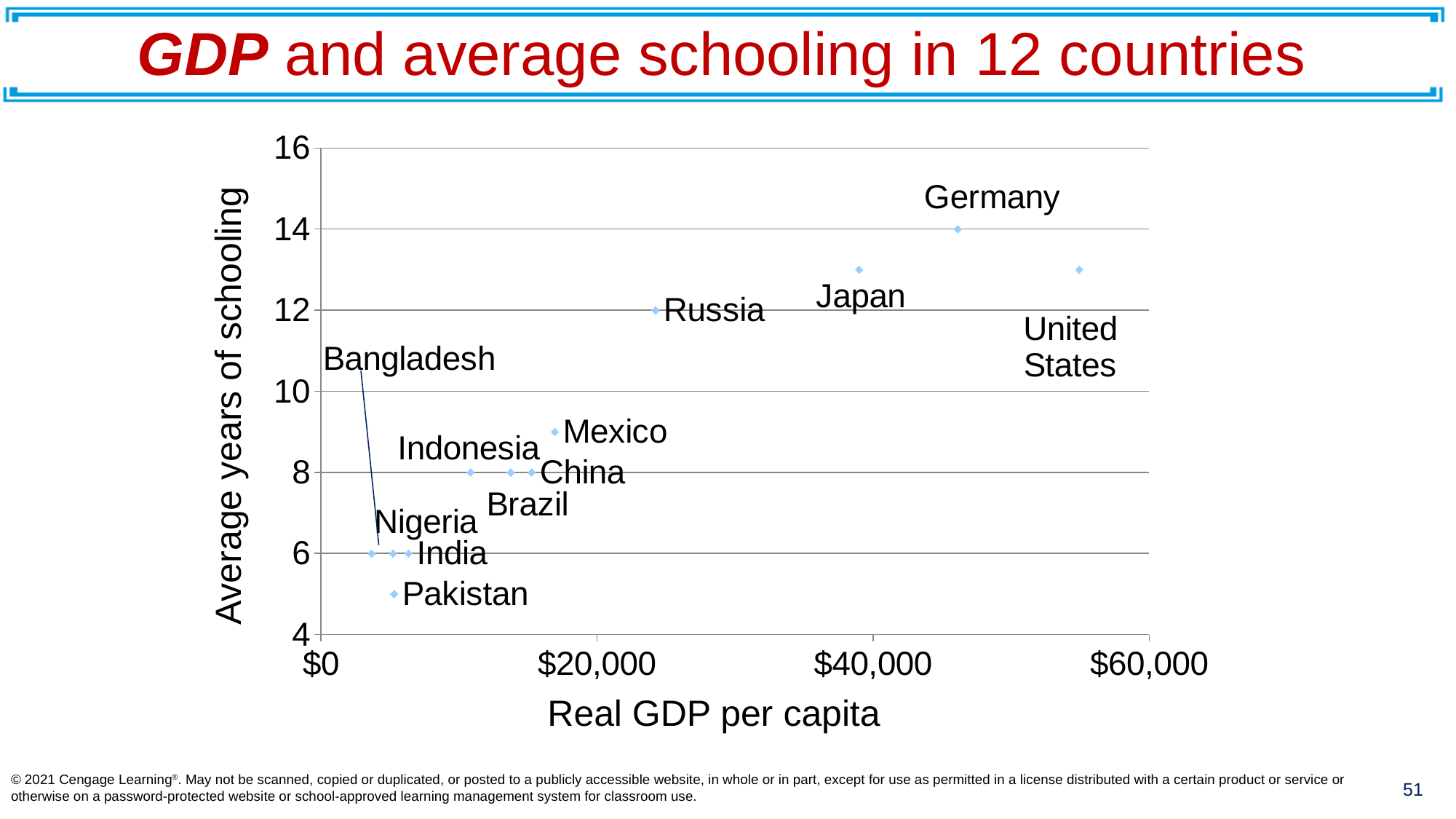
Is the real GDP per capita for Russia greater or less than $20,000? greater Which has more average years of schooling, Mexico or Indonesia? Mexico Which country has the lowest average years of schooling? Pakistan Which country has the highest average years of schooling? Germany Which country has the highest real GDP per capita? United States As real GDP per capita increases along the x axis, do average years of schooling generally rise or fall? rise Is the average years of schooling for Japan greater or less than 12? greater What is the average years of schooling for Russia? 12 What kind of chart is shown on the slide? scatter chart How many countries are plotted on the chart? 12 What is the average years of schooling for Germany? 14 What is the average years of schooling for Brazil? 8